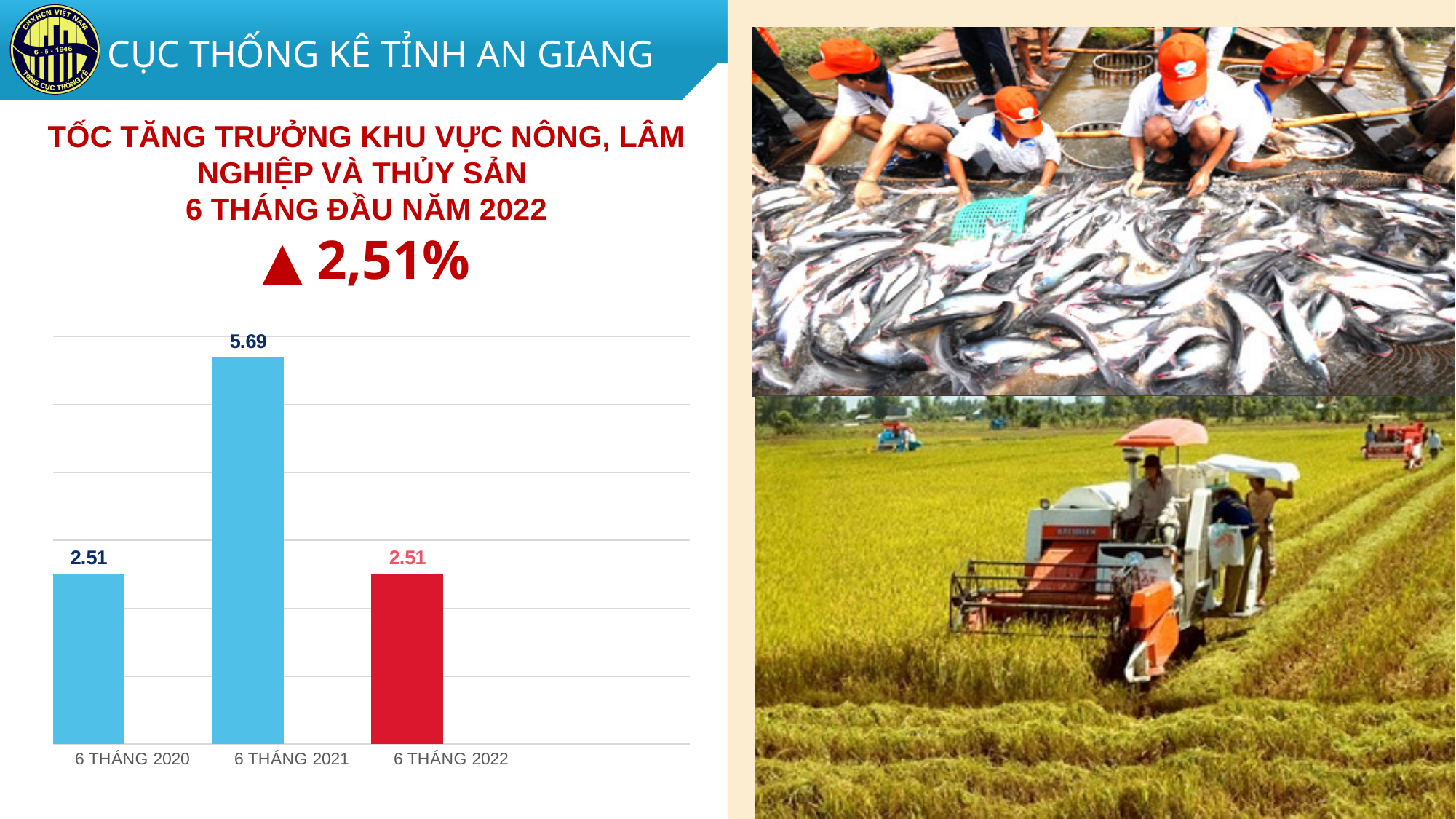
What is the difference between the values for 6 THÁNG 2021 and 6 THÁNG 2020? 3.18 How many categories are shown on the chart? 3 Which category has the highest value? 6 THÁNG 2021 What colour is the bar for 6 THÁNG 2022? Red What is the difference between the values for 6 THÁNG 2021 and 6 THÁNG 2022? 3.18 What kind of chart is shown on the slide? Bar chart What growth rate is highlighted in large text above the chart? 2,51% Do the values rise or fall from 6 THÁNG 2021 to 6 THÁNG 2022? Fall What is the value for 6 THÁNG 2021? 5.69 Which is larger, the value for 6 THÁNG 2021 or the value for 6 THÁNG 2022? 6 THÁNG 2021 What is the value for 6 THÁNG 2020? 2.51 What is the value for 6 THÁNG 2022? 2.51